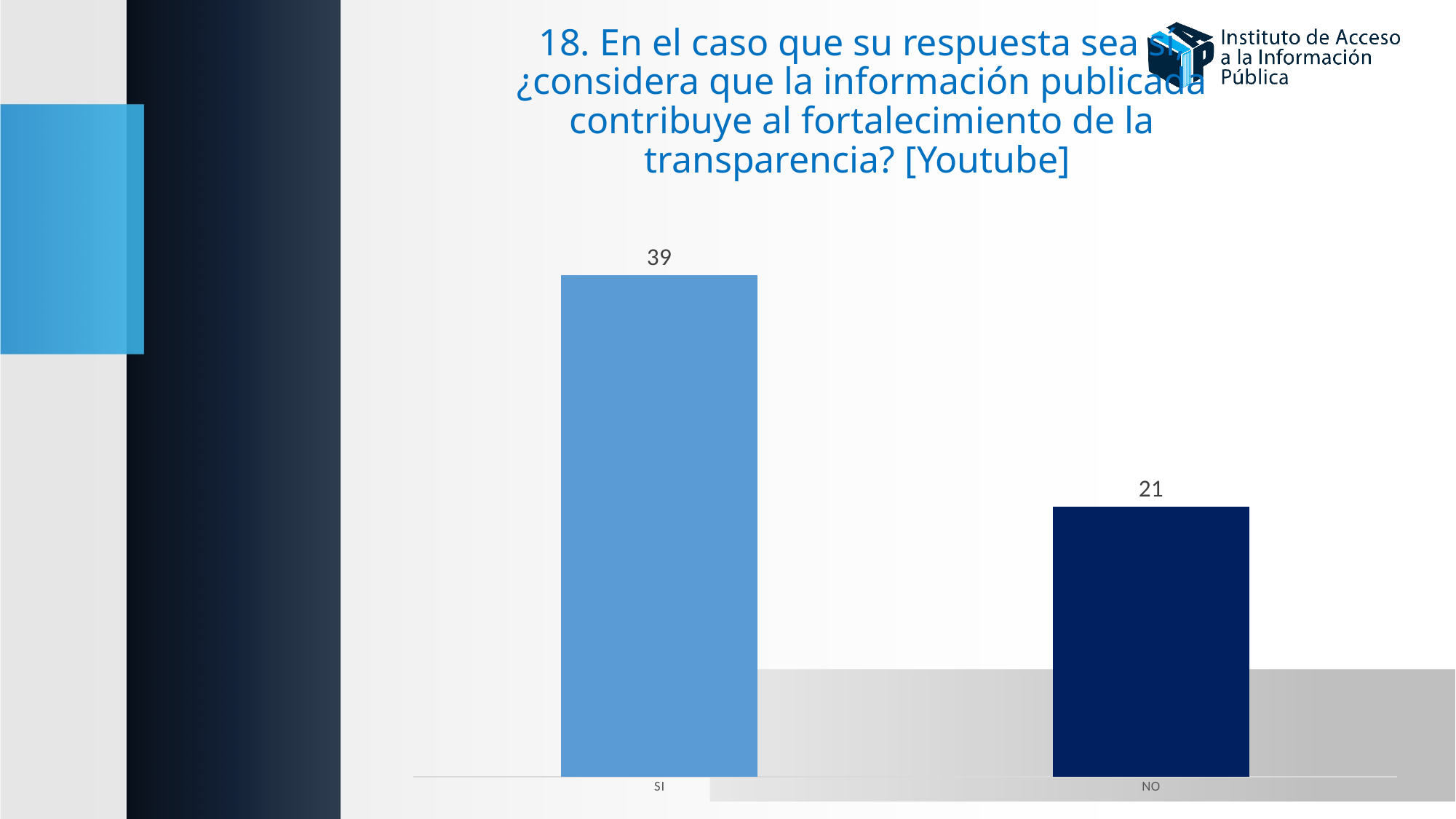
Which category has the highest value? SI Which social network is named in brackets in the chart title? Youtube Which is larger, the value for SI or the value for NO? SI What colour is the bar for NO? Dark navy blue What kind of chart is shown on the slide? Bar chart What is the value for SI? 39 How many categories are shown in the chart? 2 What is the difference between the values for SI and NO? 18 What is the total of the values for SI and NO? 60 Which category has the lowest value? NO What is the value for NO? 21